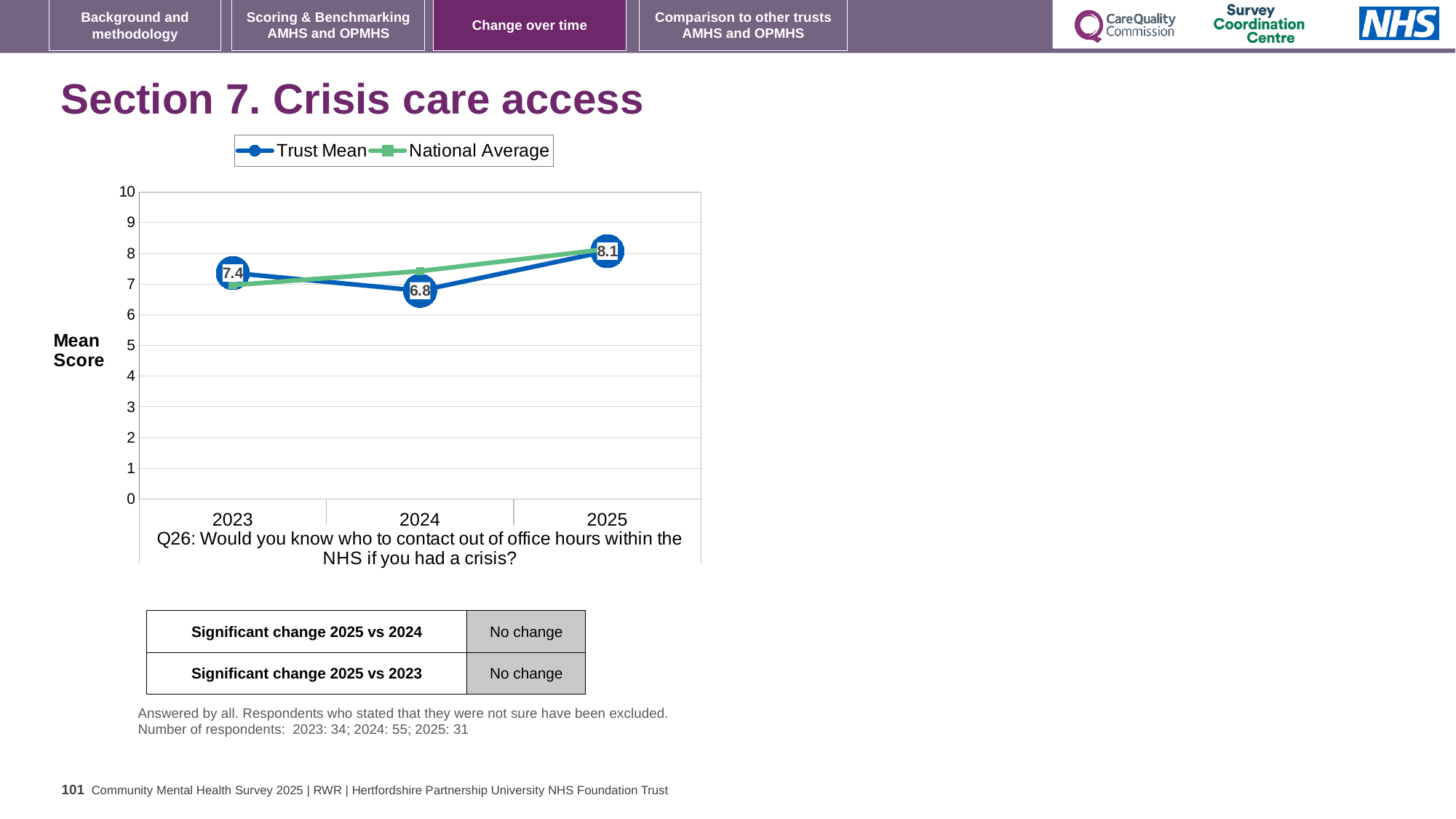
What is the Trust Mean value for 2025? 8.1 How many years are plotted on the x axis? 3 Is the National Average value for 2024 greater or less than 8? less What kind of chart is shown on the slide? line chart Which is larger, the Trust Mean in 2023 or in 2024? 2023 What is the Trust Mean value for 2023? 7.4 What is the difference between the Trust Mean in 2025 and in 2024? 1.3 What is the Trust Mean value for 2024? 6.8 In which year is the Trust Mean highest? 2025 Does the National Average rise or fall from 2023 to 2025? rise How many series does the legend list? 2 In which year is the Trust Mean lowest? 2024